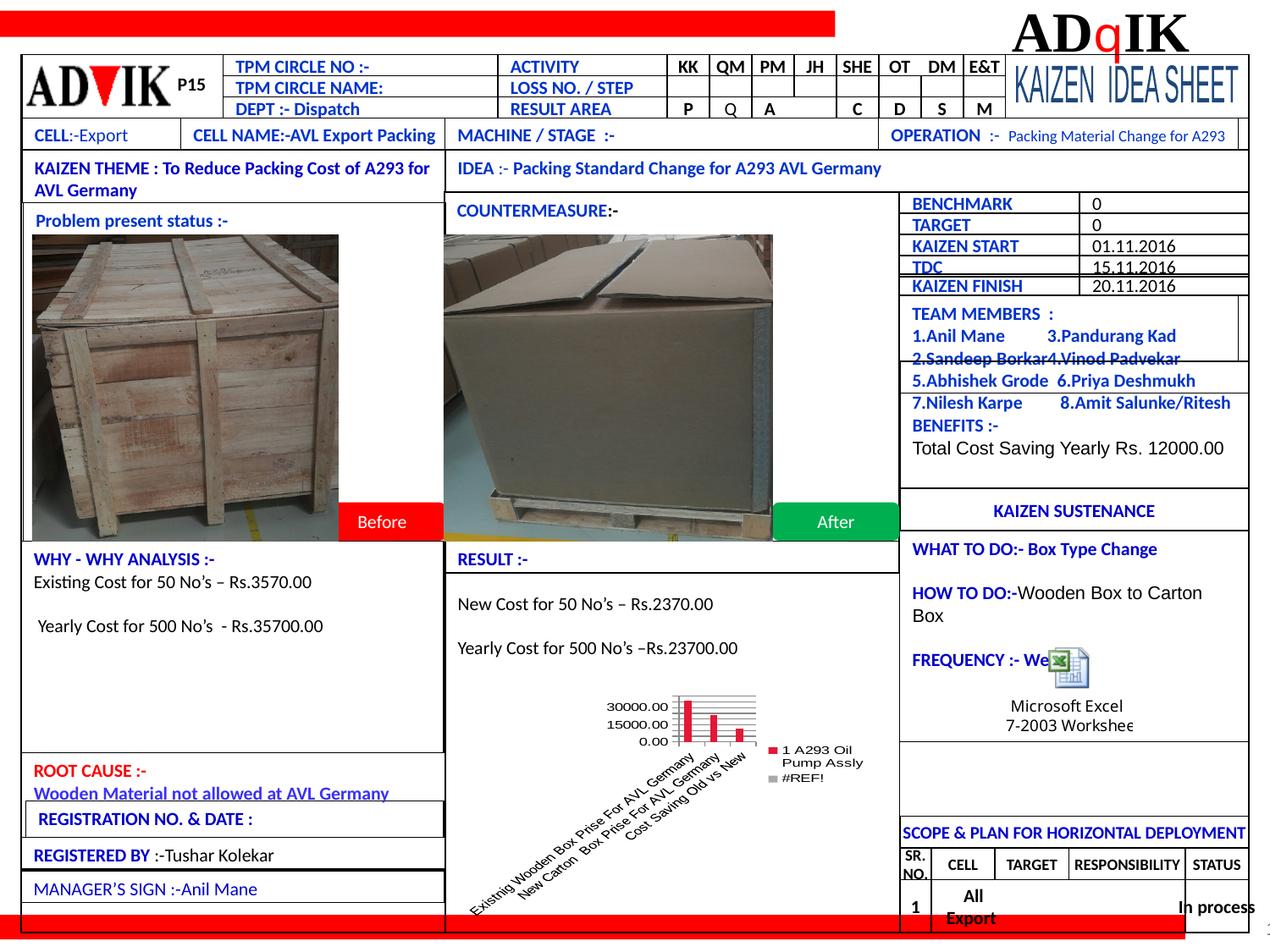
In the chart in the RESULT section, is the '1 A293 Oil Pump Assly' value for 'New Carton Box Prise For AVL Germany' greater or less than 15000.00? greater What kind of chart is shown in the RESULT section of the slide? Bar chart In the chart in the RESULT section, is the '1 A293 Oil Pump Assly' value for 'Cost Saving Old vs New' greater or less than 15000.00? less How many series does the legend of the chart in the RESULT section list? 2 In the chart in the RESULT section, is the '1 A293 Oil Pump Assly' value for 'Existing Wooden Box Prise For AVL Germany' greater or less than 30000.00? greater In the chart in the RESULT section, do the '1 A293 Oil Pump Assly' values rise or fall from left to right along the x axis? fall In the chart in the RESULT section, which category has the lowest value for the '1 A293 Oil Pump Assly' series? Cost Saving Old vs New In the chart in the RESULT section, which category has the highest value for the '1 A293 Oil Pump Assly' series? Existing Wooden Box Prise For AVL Germany How many categories are plotted along the x axis of the chart in the RESULT section? 3 What is the second legend entry of the chart in the RESULT section? #REF! What is the first legend entry of the chart in the RESULT section? 1 A293 Oil Pump Assly In the chart in the RESULT section, which is larger for the '1 A293 Oil Pump Assly' series: 'Existing Wooden Box Prise For AVL Germany' or 'New Carton Box Prise For AVL Germany'? Existing Wooden Box Prise For AVL Germany